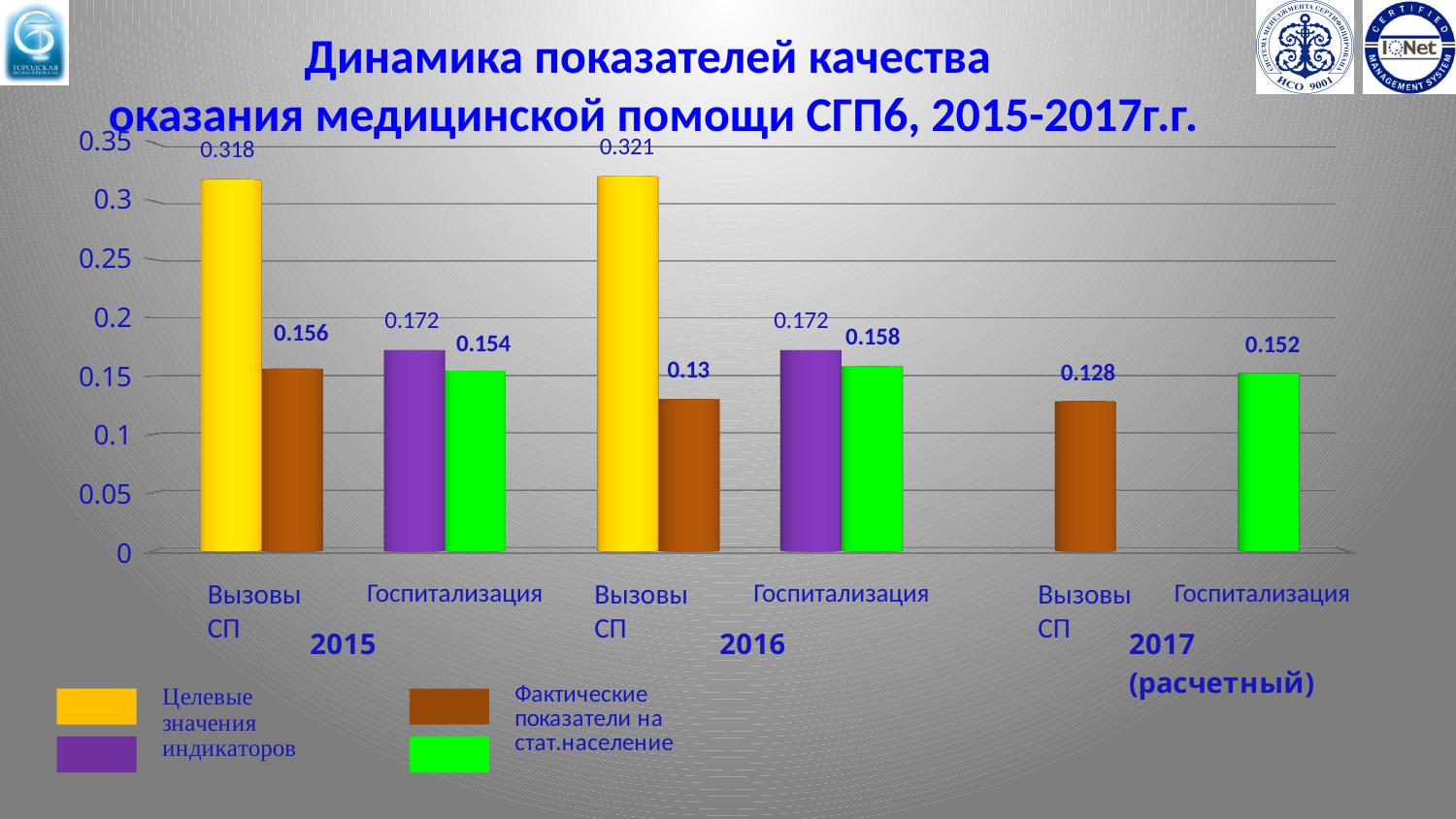
What is the target value for Госпитализация in 2016? 0.172 How do the actual values for Вызовы СП change from 2015 to 2017? They fall (0.156, 0.13, 0.128) What is the actual value for Госпитализация in 2017 (расчетный)? 0.152 Which is larger: the actual value for Госпитализация in 2015 or in 2016? 2016 (0.158) Which bar on the chart has the lowest value? Вызовы СП actual value in 2017 (0.128) Is the target value for Вызовы СП in 2016 greater or less than 0.3? greater What does the yellow colour in the legend represent? Целевые значения индикаторов What is the target value (Целевые значения индикаторов) for Вызовы СП in 2015? 0.318 What type of chart is shown on the slide? Bar chart What is the actual value (Фактические показатели на стат.население) for Вызовы СП in 2016? 0.13 Which bar on the chart has the highest value? Вызовы СП target value in 2016 (0.321) What is the difference between the target value and the actual value for Вызовы СП in 2015? 0.162